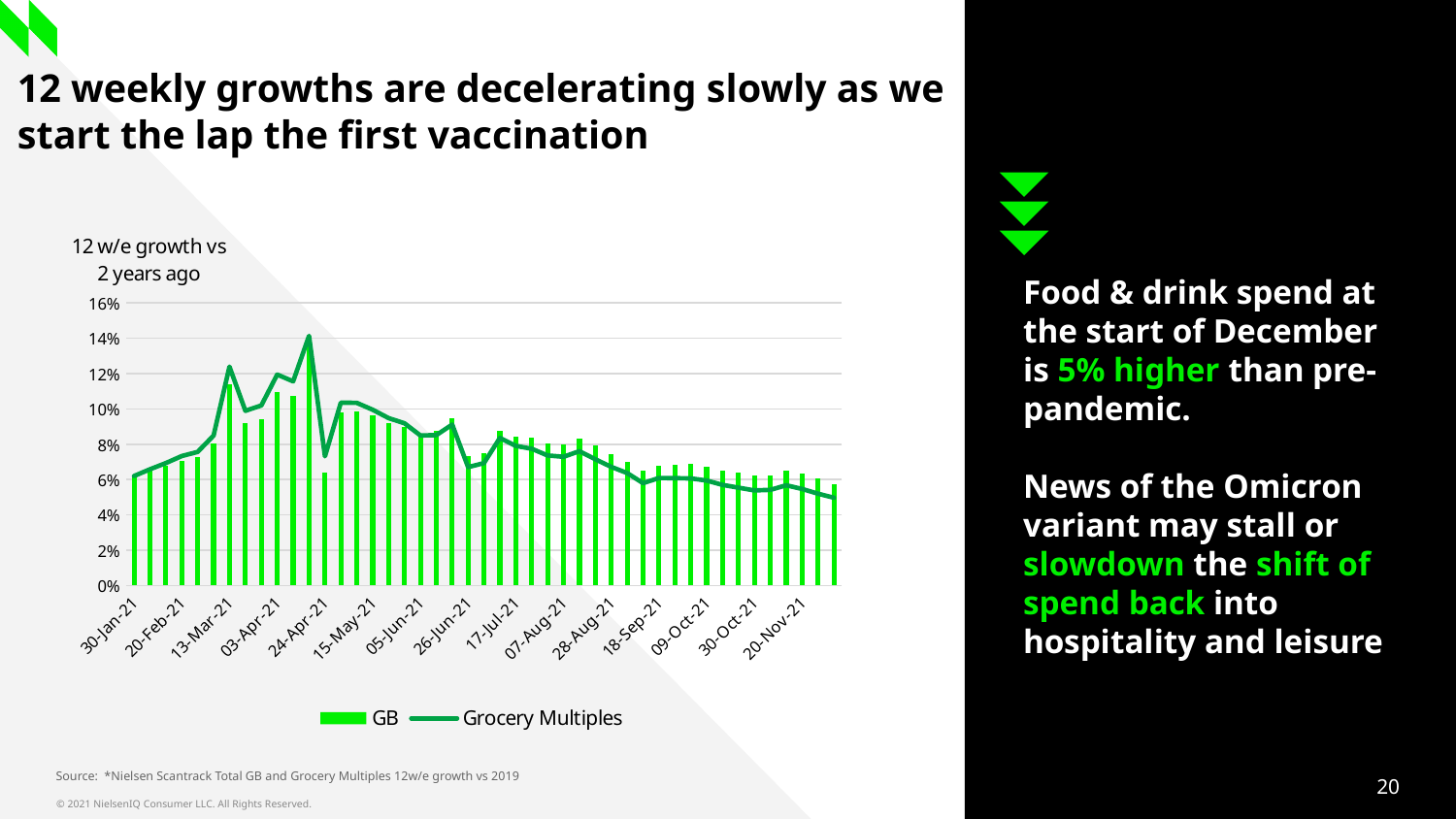
How many date labels are shown along the x axis of the chart? 15 What is the highest value shown on the vertical axis of the chart? 16% How many series does the chart legend list? 2 Which series is drawn as a line in the chart? Grocery Multiples Is the GB bar at 30-Jan-21 greater or less than 8%? less Is the Grocery Multiples value at 20-Nov-21 greater or less than 8%? less From 26-Jun-21 to 20-Nov-21, do the GB bars generally rise or fall? fall Is the GB bar at 20-Nov-21 greater or less than 8%? less What is the title shown above the vertical axis of the chart? 12 w/e growth vs 2 years ago What kind of chart is shown on the slide? A combined bar and line chart Which series is drawn as bars in the chart? GB